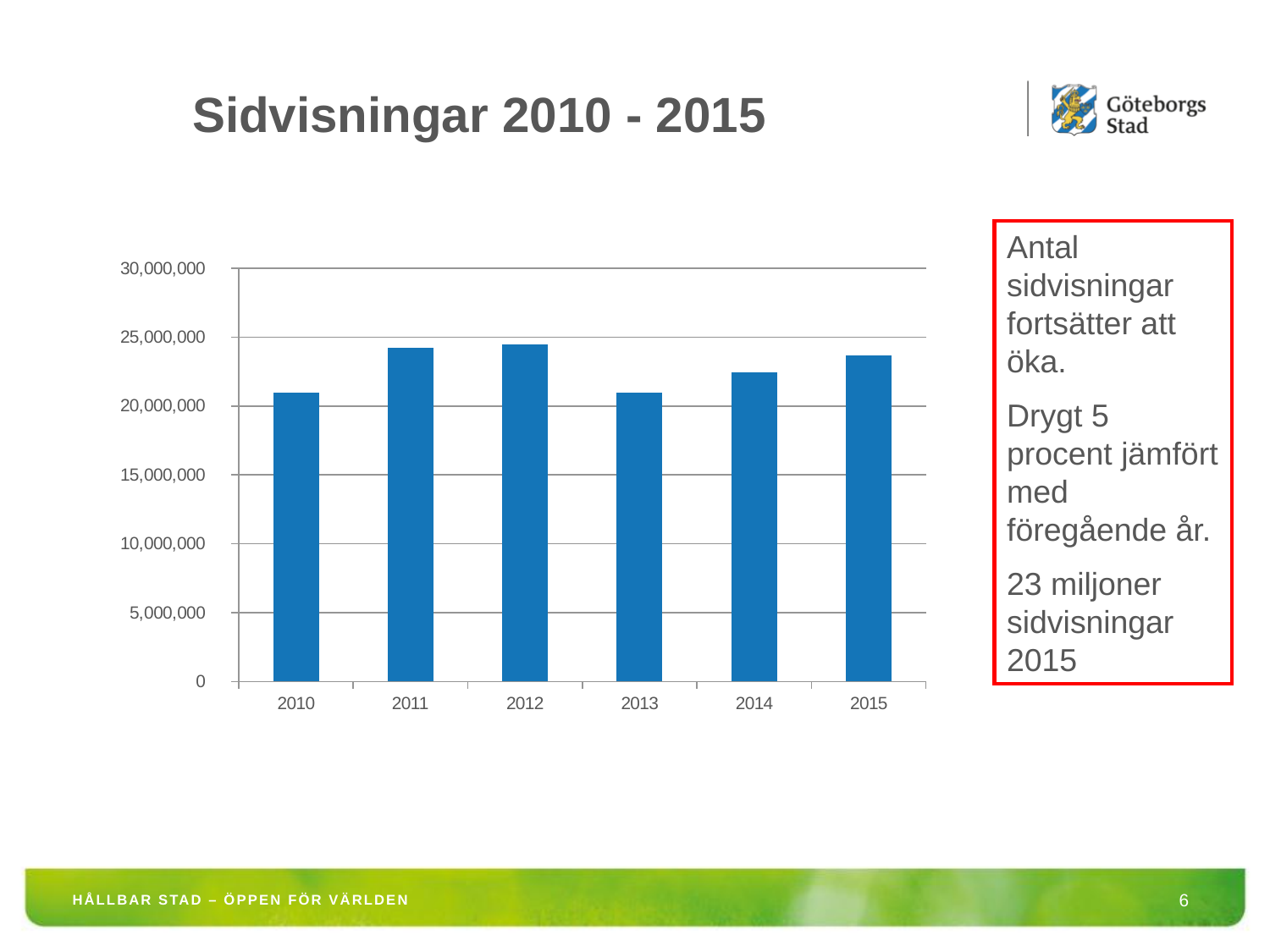
What kind of chart is shown on the slide? bar chart Is the value for 2014 greater or less than 25,000,000? less Is the value for 2011 greater or less than 25,000,000? less Is the value for 2015 greater or less than 20,000,000? greater What is the title of the slide's chart? Sidvisningar 2010 - 2015 How many years (bars) are plotted in the chart? 6 Do the values rise or fall from 2013 to 2015? rise Do the values rise or fall from 2012 to 2013? fall Which year has the larger value, 2010 or 2011? 2011 Which year has the larger value, 2012 or 2013? 2012 Which year has the larger value, 2014 or 2015? 2015